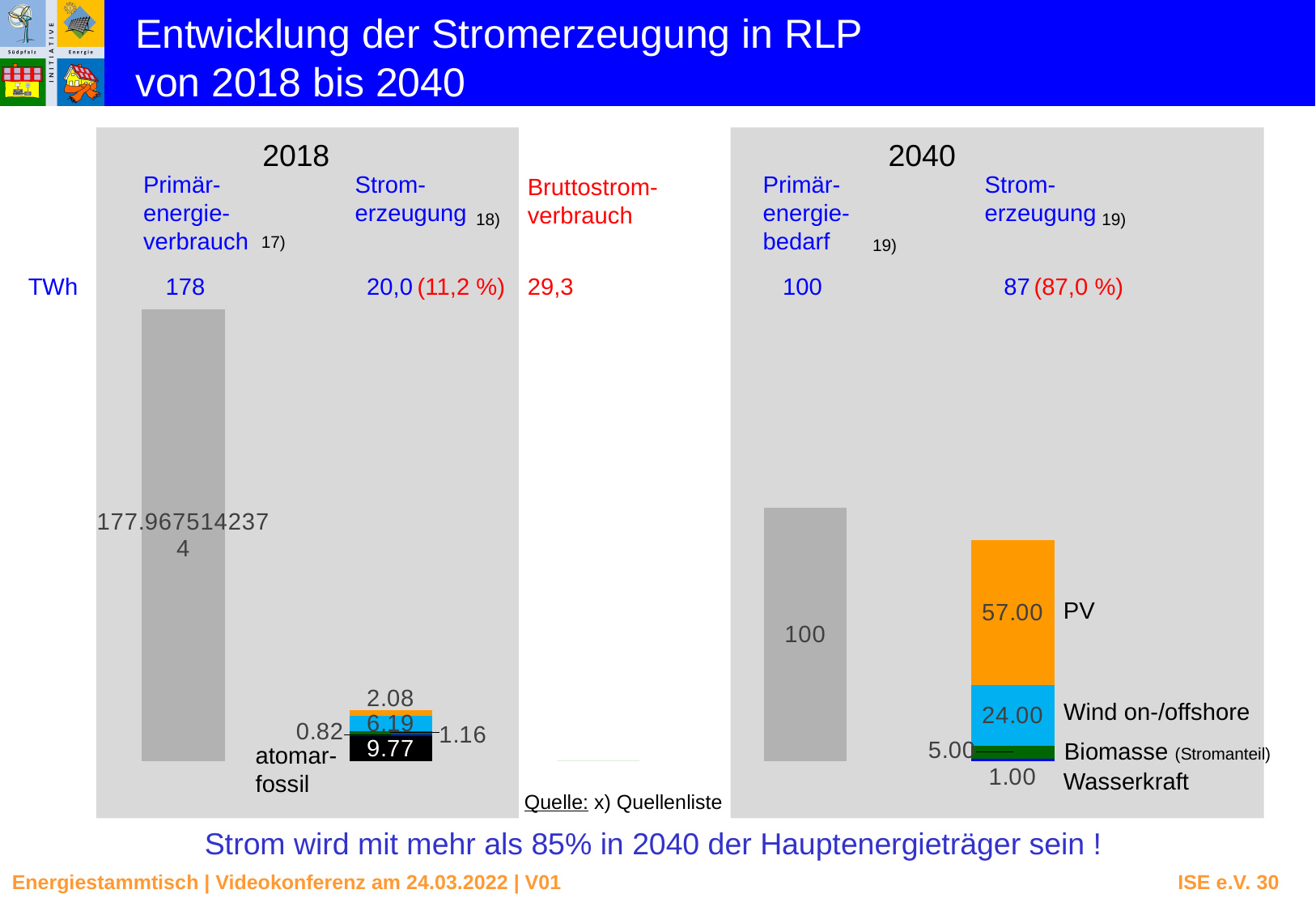
In the 2040 chart, what is the value for Wasserkraft? 1.00 In the 2018 chart, what is the value of the atomar-fossil segment? 9.77 In the 2040 chart, what is the value for Biomasse (Stromanteil)? 5.00 In the 2040 chart, which segment of the Stromerzeugung bar is the largest? PV In the 2040 chart, which segment of the Stromerzeugung bar is the smallest? Wasserkraft In the 2040 chart, what is the value for Wind on-/offshore? 24.00 In the 2018 chart, what value in TWh is given for Primärenergieverbrauch? 178 In the 2018 chart, what is the total Stromerzeugung in TWh? 20,0 In the 2040 chart, how much larger is the PV value than the Wind on-/offshore value? 33.00 What kind of chart is used on this slide to show the 2040 values? Bar chart In the 2040 chart, what is the total of the stacked Stromerzeugung bar in TWh? 87 In the 2040 chart, what is the value of the PV segment of the Stromerzeugung bar? 57.00